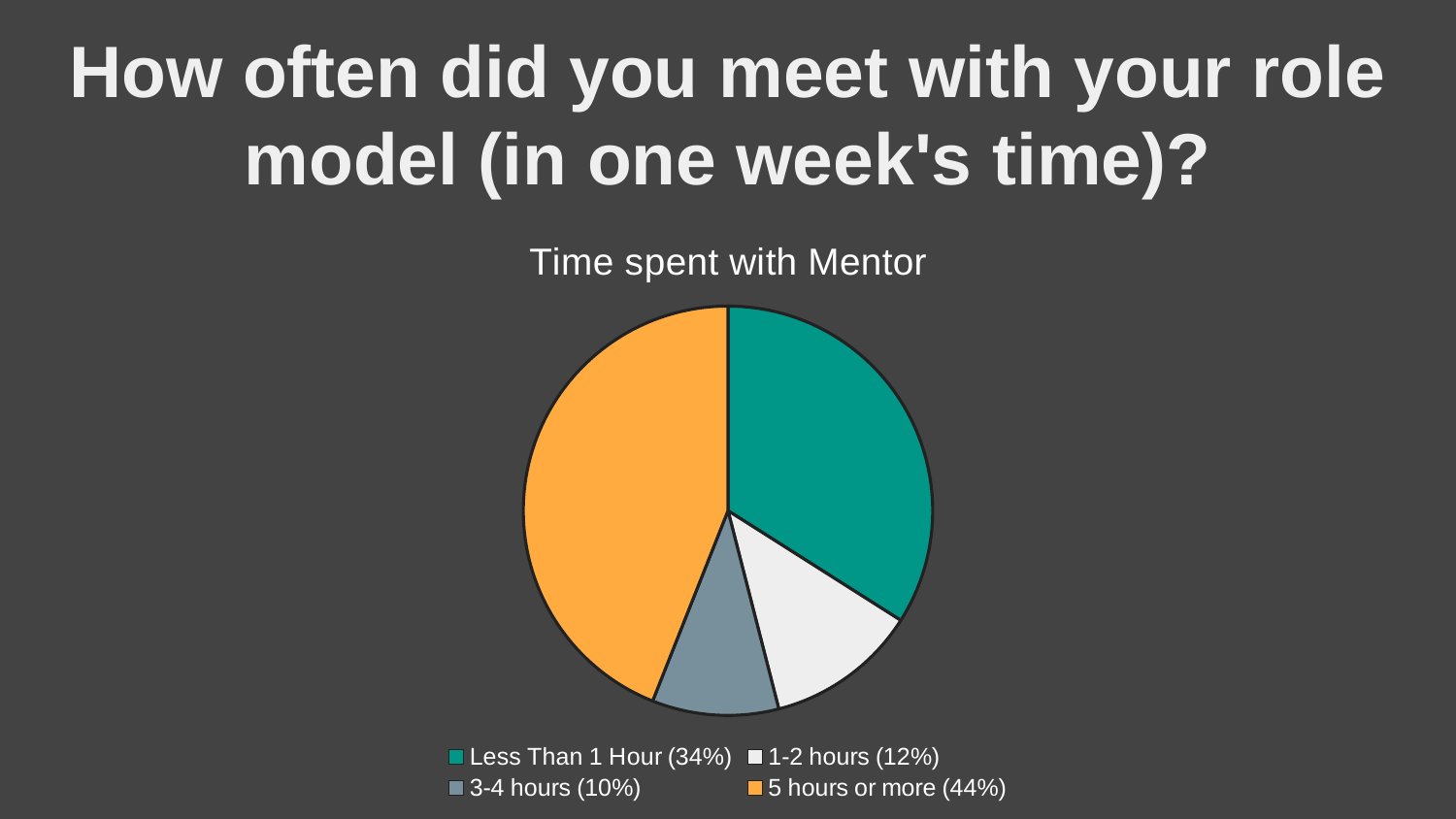
What colour is the "5 hours or more" slice? orange What is the title of the chart? Time spent with Mentor What share of the pie is "1-2 hours"? 12% What is the difference in percentage points between "5 hours or more" and "Less Than 1 Hour"? 10 What share of the pie is "3-4 hours"? 10% How many slices does the pie chart have? 4 Which category has the smallest slice? 3-4 hours What kind of chart is shown on the slide? pie chart Which is larger, the "1-2 hours" slice or the "3-4 hours" slice? 1-2 hours What share of the pie is "Less Than 1 Hour"? 34% Which category has the largest slice? 5 hours or more